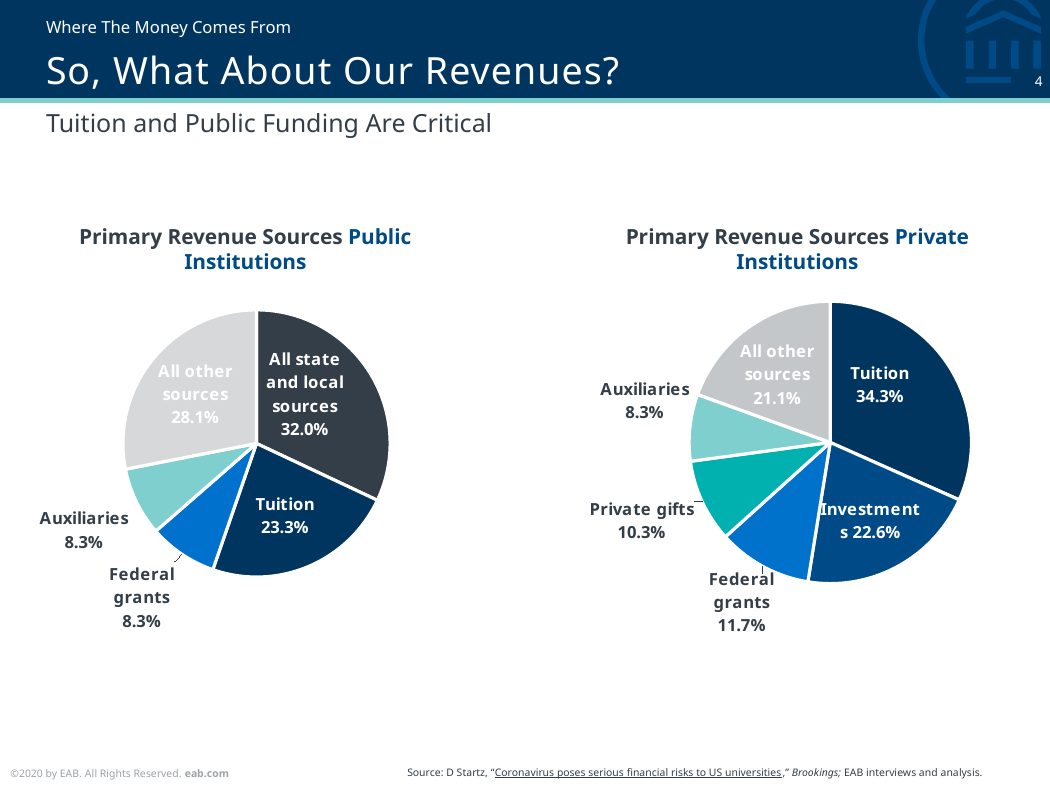
How many categories are shown in the Primary Revenue Sources Private Institutions chart? 6 In the Primary Revenue Sources Public Institutions chart, which category has the largest share? All state and local sources What type of chart is used for the Primary Revenue Sources Public Institutions chart? Pie chart In the Primary Revenue Sources Public Institutions chart, what share is Tuition? 23.3% In the Primary Revenue Sources Private Institutions chart, what share is Private gifts? 10.3% In the Primary Revenue Sources Private Institutions chart, what share is Investments? 22.6% In the Primary Revenue Sources Private Institutions chart, which category has the largest share? Tuition How many categories are shown in the Primary Revenue Sources Public Institutions chart? 5 In the Primary Revenue Sources Private Institutions chart, which is larger: Federal grants or Private gifts? Federal grants In the Primary Revenue Sources Public Institutions chart, what share is All state and local sources? 32.0% In the Primary Revenue Sources Private Institutions chart, which category has the smallest share? Auxiliaries What is the difference between the Tuition share in the Private Institutions chart and the Tuition share in the Public Institutions chart? 11.0%